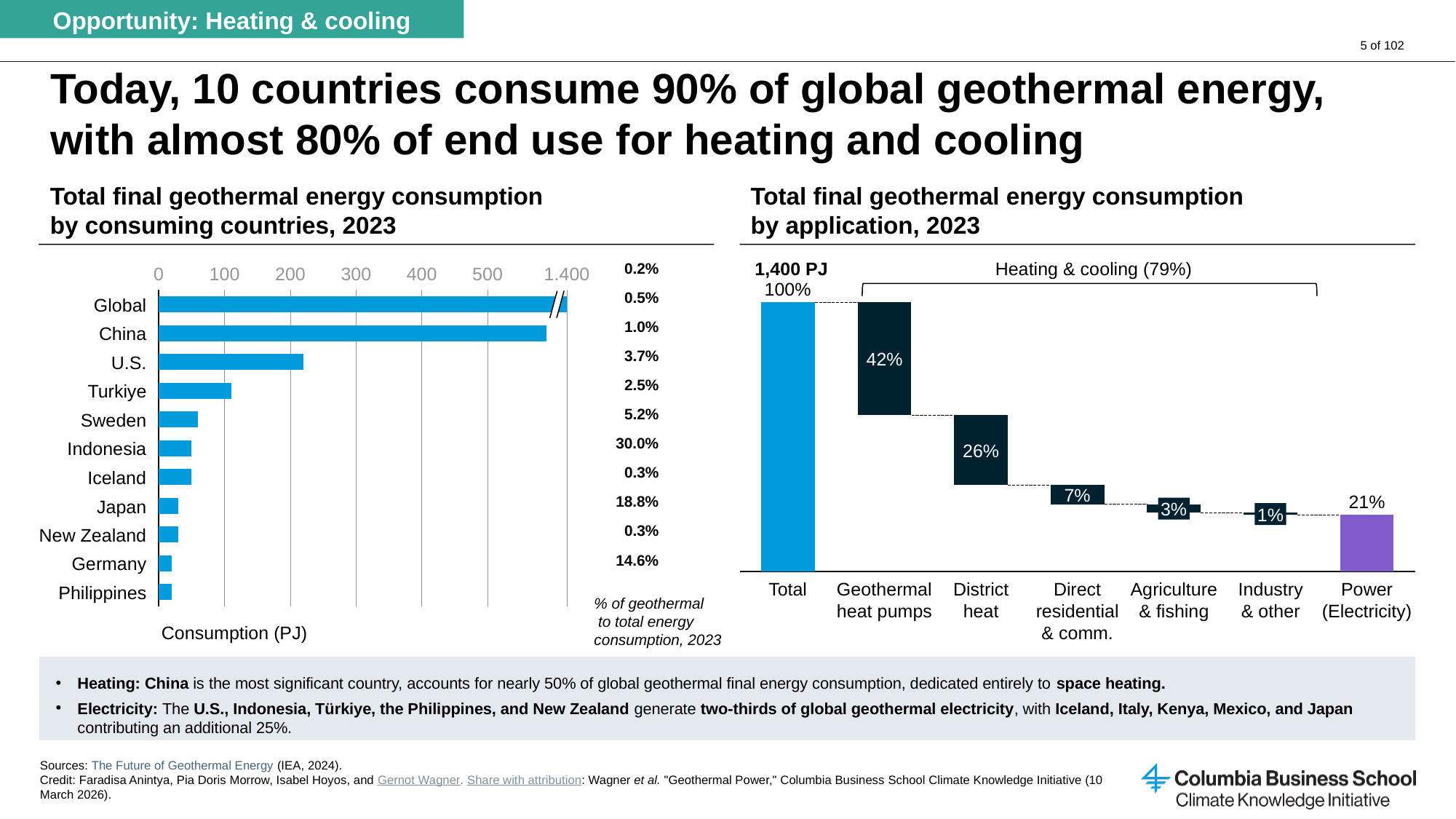
In the left chart (consumption by consuming countries), is the consumption value for U.S. greater or less than 300? less In the right chart (consumption by application, 2023), which is larger: District heat or Power (Electricity)? District heat In the right chart (consumption by application, 2023), what percentage is shown for Geothermal heat pumps? 42% In the right chart (consumption by application, 2023), what total consumption in PJ is labelled above the Total bar? 1,400 PJ In the left chart, what is the '% of geothermal to total energy consumption, 2023' shown for New Zealand? 18.8% In the left chart (consumption by consuming countries), is the consumption value for Turkiye greater or less than 200? less What kind of chart is the left chart, 'Total final geothermal energy consumption by consuming countries, 2023'? Bar chart In the left chart (consumption by consuming countries), which individual country has the highest consumption? China In the right chart (consumption by application, 2023), what is the difference in percentage points between Geothermal heat pumps and District heat? 16 percentage points In the left chart, what is the '% of geothermal to total energy consumption, 2023' shown for Iceland? 30.0% In the right chart (consumption by application, 2023), what percentage is shown for Power (Electricity)? 21% In the left chart (consumption by consuming countries), how many bars are plotted? 11